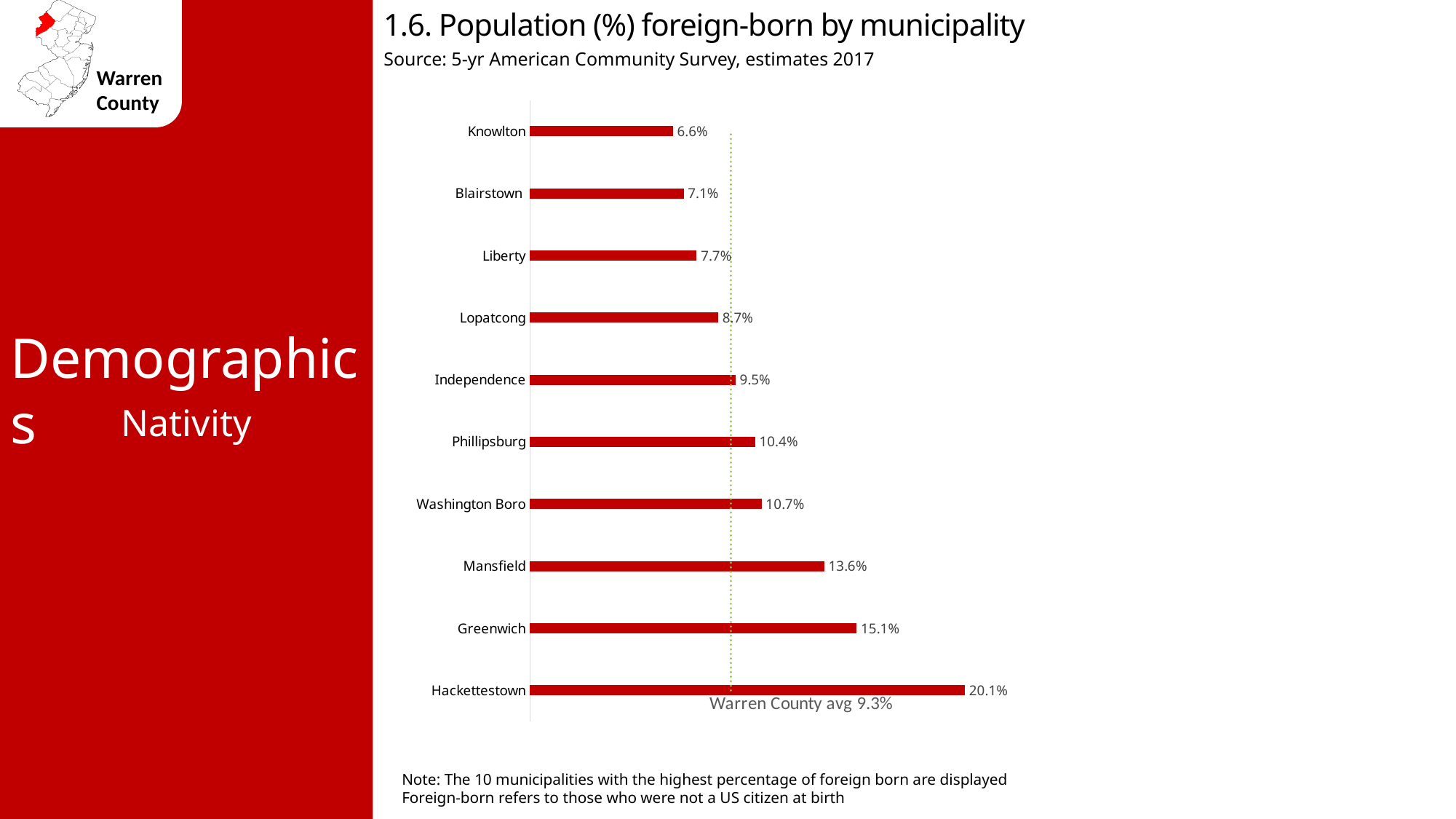
What is the difference in foreign-born percentage between Hackettestown and Greenwich? 5.0% What is the percentage of foreign-born population in Phillipsburg? 10.4% Which municipality has the highest percentage of foreign-born population? Hackettestown Which municipality has the lowest percentage of foreign-born population? Knowlton What kind of chart is used to show the foreign-born population by municipality? Bar chart How many municipalities are shown in the chart? 10 What is the percentage of foreign-born population in Hackettstown? 20.1% What is the percentage of foreign-born population in Knowlton? 6.6% Which has a higher foreign-born percentage, Washington Boro or Liberty? Washington Boro What is the Warren County average foreign-born percentage shown by the dotted line? 9.3% What is the difference in foreign-born percentage between Mansfield and Lopatcong? 4.9% What is the source of the data shown in the chart? 5-yr American Community Survey, estimates 2017